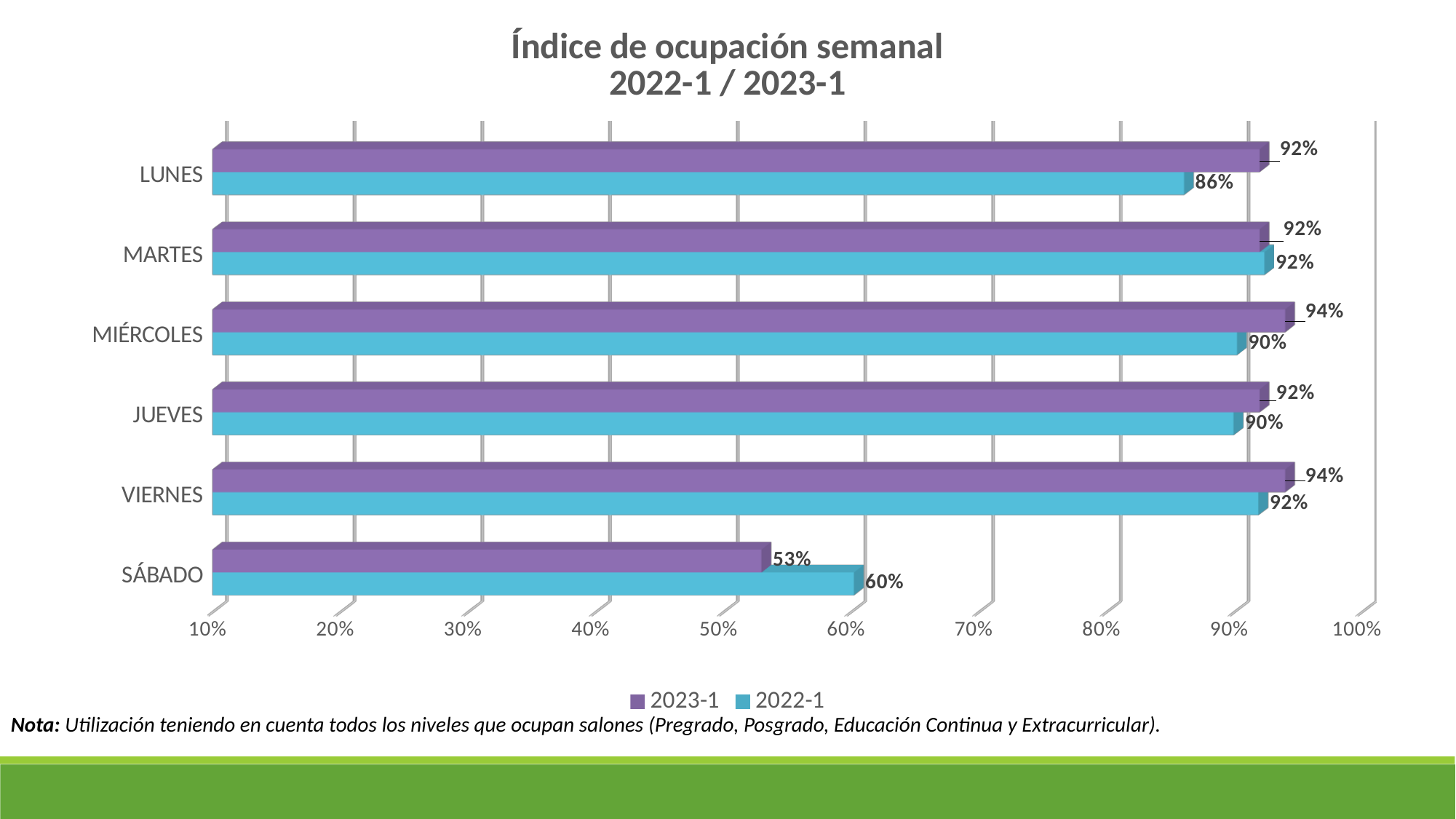
Which day has the lowest value in the 2023-1 series? SÁBADO What is the value for LUNES in the 2023-1 series? 92% What is the difference between the 2023-1 and 2022-1 values for LUNES? 6% Which is larger for VIERNES, the 2023-1 value or the 2022-1 value? 2023-1 What is the difference between the 2022-1 and 2023-1 values for SÁBADO? 7% What is the value for MIÉRCOLES in the 2022-1 series? 90% How many series does the legend list? 2 How many days are shown on the chart? 6 Which day has the lowest value in the 2022-1 series? SÁBADO What is the value for SÁBADO in the 2022-1 series? 60% Which is larger for SÁBADO, the 2023-1 value or the 2022-1 value? 2022-1 What kind of chart is shown on the slide? Bar chart